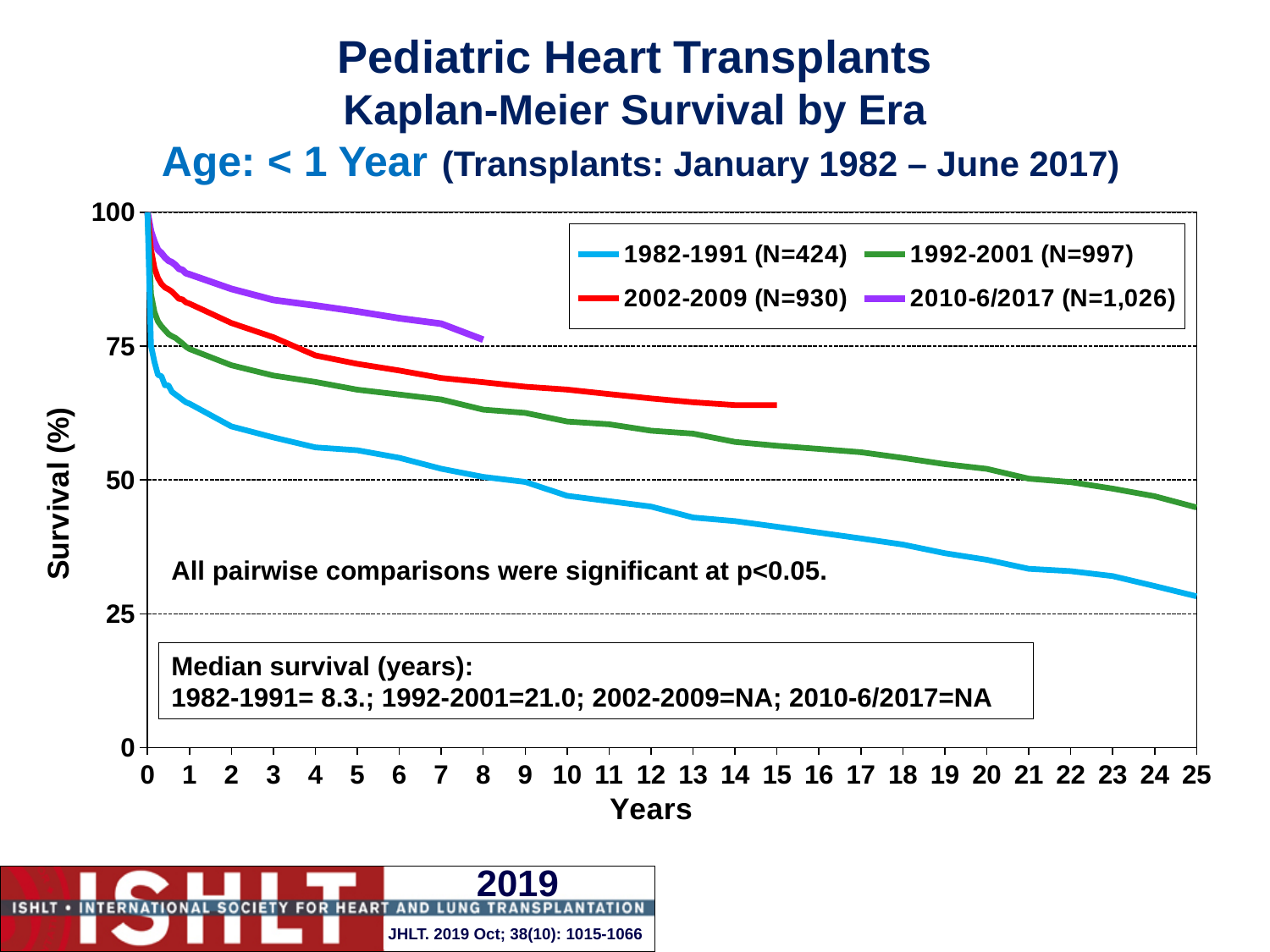
What kind of chart is shown on the slide? Line chart What is the median survival in years for the 1992-2001 era, as printed on the slide? 21.0 Which era has the highest survival curve at 5 years? 2010-6/2017 Is the survival for the 1982-1991 era at 25 years greater or less than 50? less Which era has the lowest survival curve at 5 years? 1982-1991 Do the survival curves rise or fall as years since transplant increase? Fall Is the survival for the 2002-2009 era at 10 years greater or less than 50? greater What is the median survival in years for the 1982-1991 era, as printed on the slide? 8.3 What median survival is given for the 2002-2009 era? NA At 10 years, which era has higher survival: 2002-2009 or 1982-1991? 2002-2009 What is the N shown in the legend for the 2010-6/2017 era? N=1,026 How many transplant eras (series) does the legend list? 4